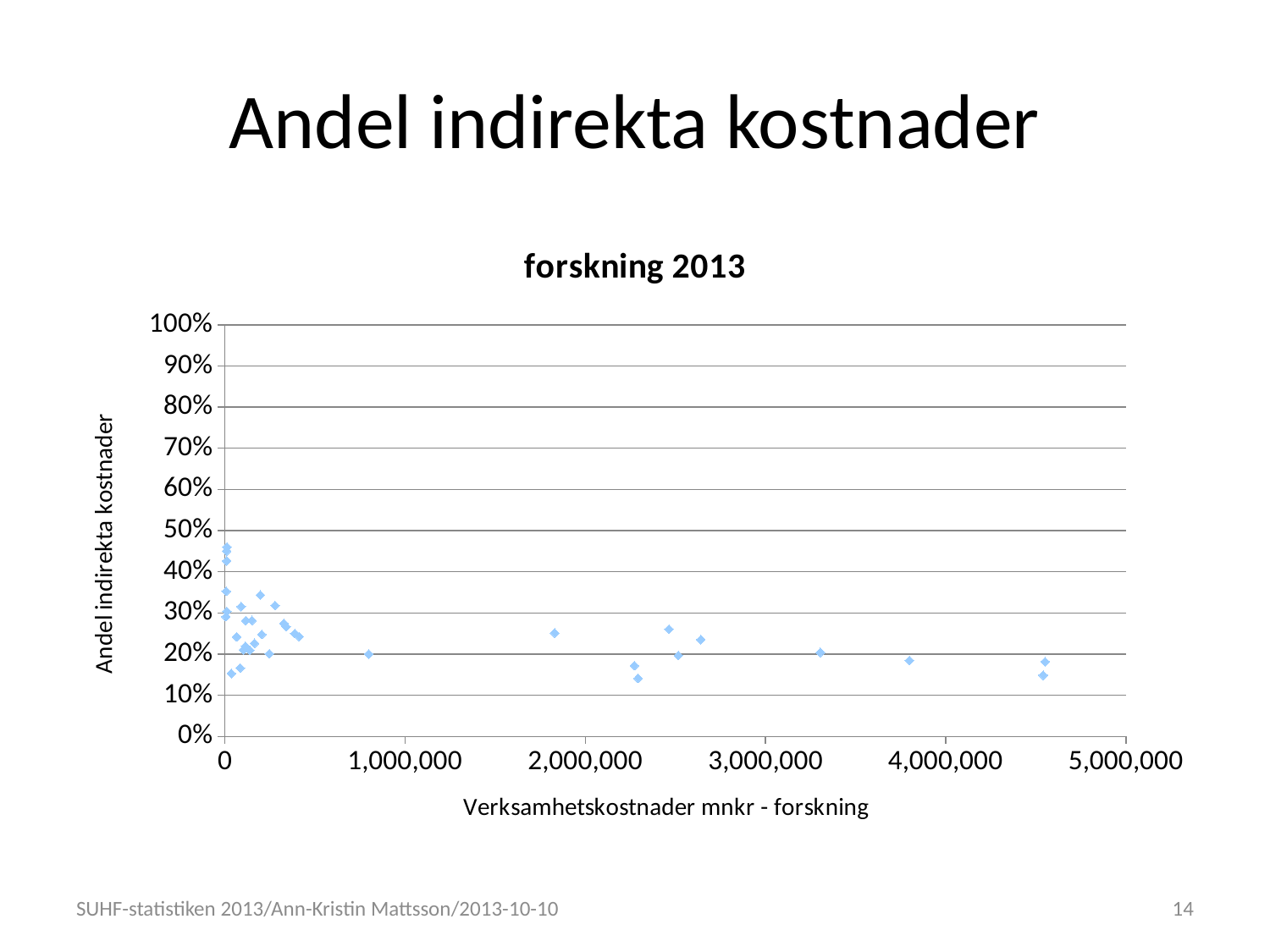
What kind of chart is shown on the slide? scatter chart What is the title of the chart? forskning 2013 Is the highest plotted point on the chart greater or less than 50% on the vertical axis? less Are the points with the highest vertical-axis values found at the low end or the high end of the horizontal axis? low end Is the vertical-axis value of the rightmost plotted points greater or less than 30%? less Is the horizontal-axis value of the rightmost plotted point greater or less than 4,000,000? greater What is the label of the vertical axis? Andel indirekta kostnader What is the maximum value shown on the vertical axis? 100%